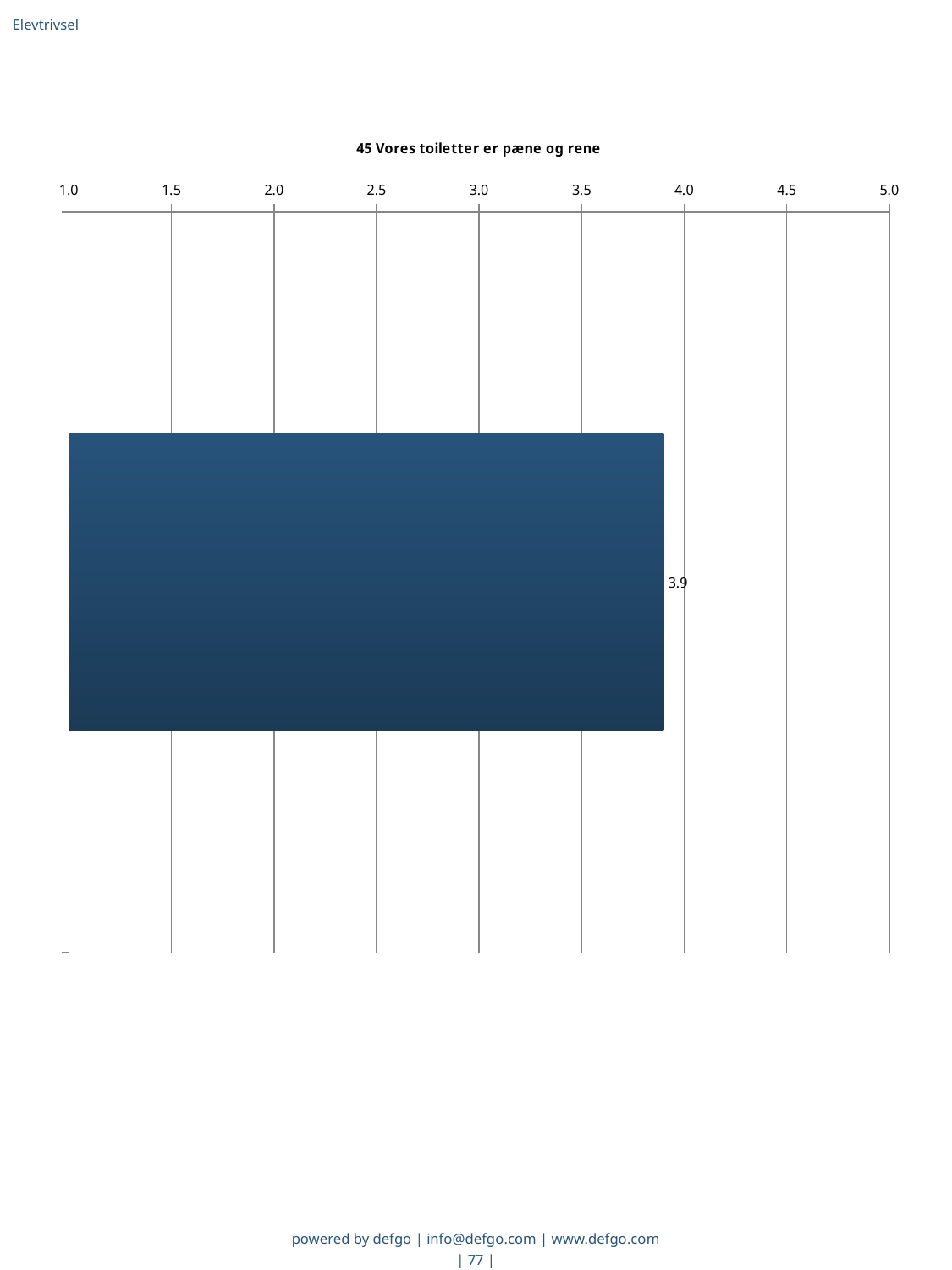
What value is shown by the bar in the chart '45 Vores toiletter er pæne og rene'? 3.9 Is the bar in the chart horizontal or vertical? horizontal What kind of chart is shown on the slide? bar chart What is the title of the chart? 45 Vores toiletter er pæne og rene Is the value of the bar greater or less than 3.5? greater Is the value of the bar greater or less than 4.0? less How many bars are plotted in the chart? 1 What is the maximum value shown on the chart's axis? 5.0